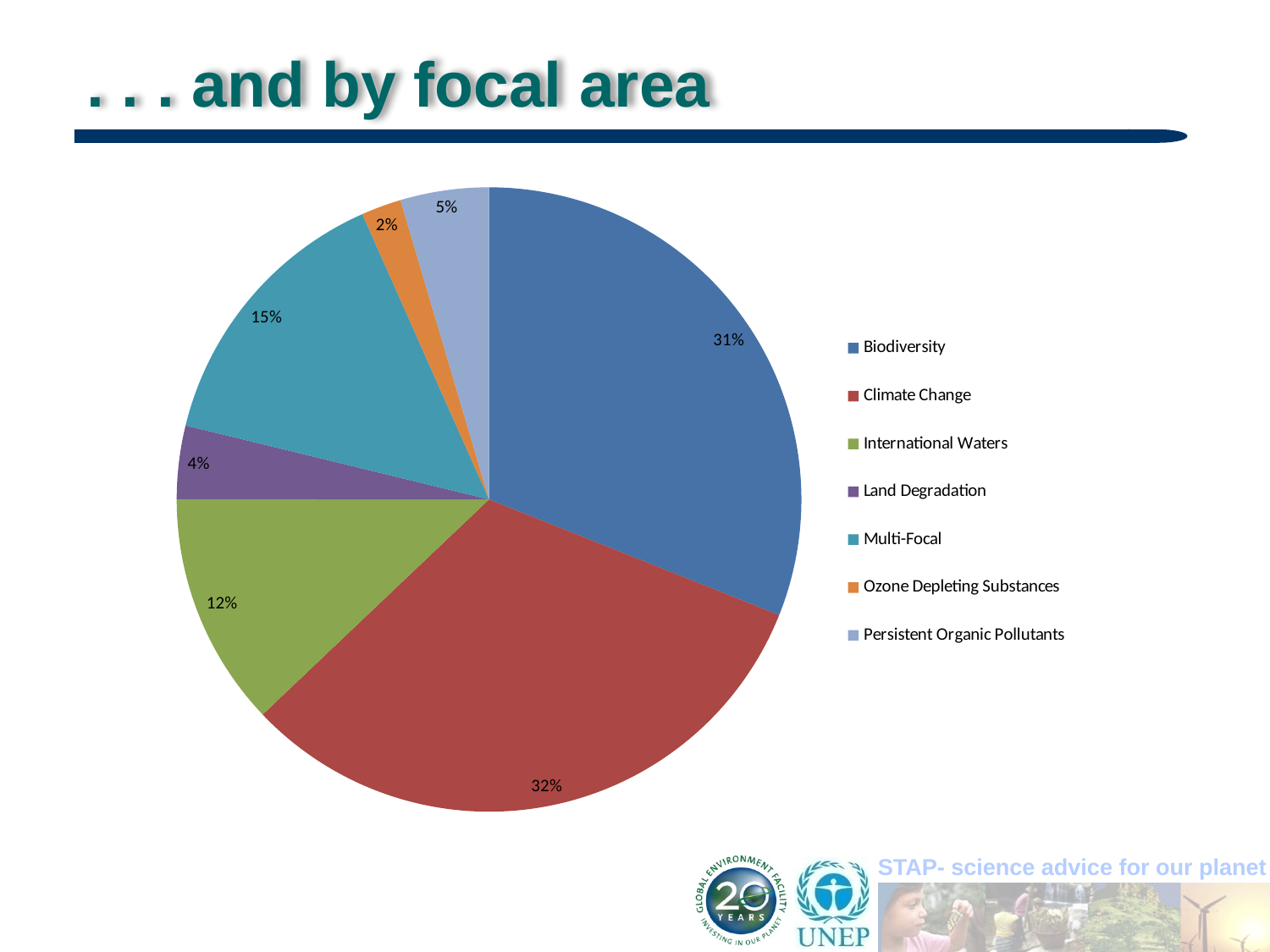
Which focal area has the smallest slice of the pie? Ozone Depleting Substances Which is larger, the Persistent Organic Pollutants slice or the Land Degradation slice? Persistent Organic Pollutants What is the title of the slide containing the pie chart? . . . and by focal area What share of the pie does Land Degradation represent? 4% What share of the pie does Multi-Focal represent? 15% What share of the pie does Climate Change represent? 32% What kind of chart is shown on the slide? pie chart How many focal areas are shown in the pie chart? 7 Which focal area has the largest slice of the pie? Climate Change What is the difference in percentage points between the Multi-Focal and International Waters slices? 3%